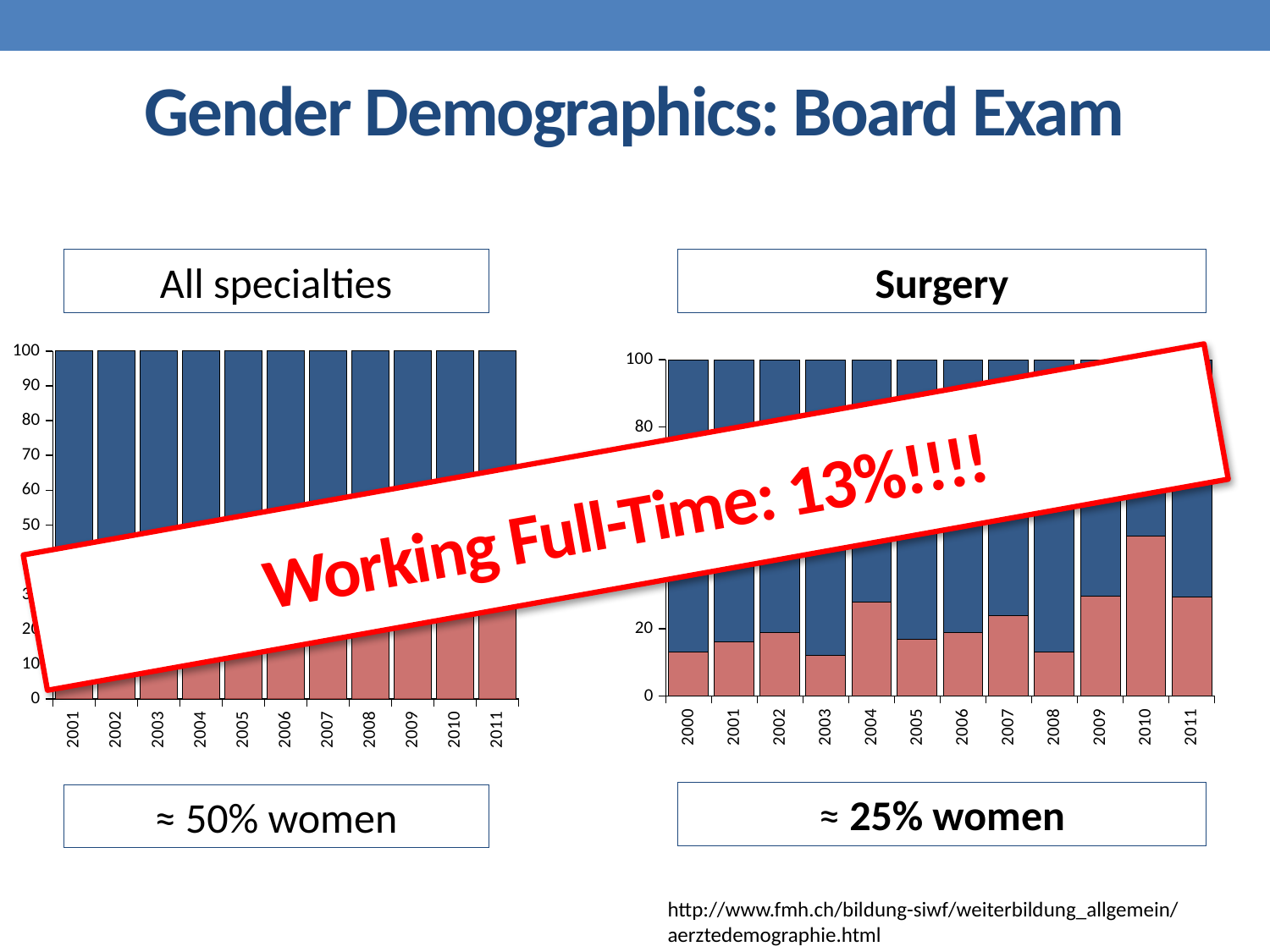
In the Surgery chart, is the lower (pink) segment for 2003 greater or less than 20? less In the Surgery chart, what is the total height of the stacked bar for 2005? 100 What is the title of the slide containing the two charts? Gender Demographics: Board Exam In the Surgery chart, is the lower (pink) segment for 2004 greater or less than 20? greater In the Surgery chart, is the lower (pink) segment for 2010 greater or less than 40? greater What percentage of women is stated in the caption below the Surgery chart? ≈ 25% women How many years are shown on the x axis of the Surgery chart? 12 In the Surgery chart, which year has the tallest lower (pink) segment? 2010 In the Surgery chart, which year has the larger lower (pink) segment, 2010 or 2003? 2010 What kind of chart is the Surgery chart? bar chart How many years are shown on the x axis of the All specialties chart? 11